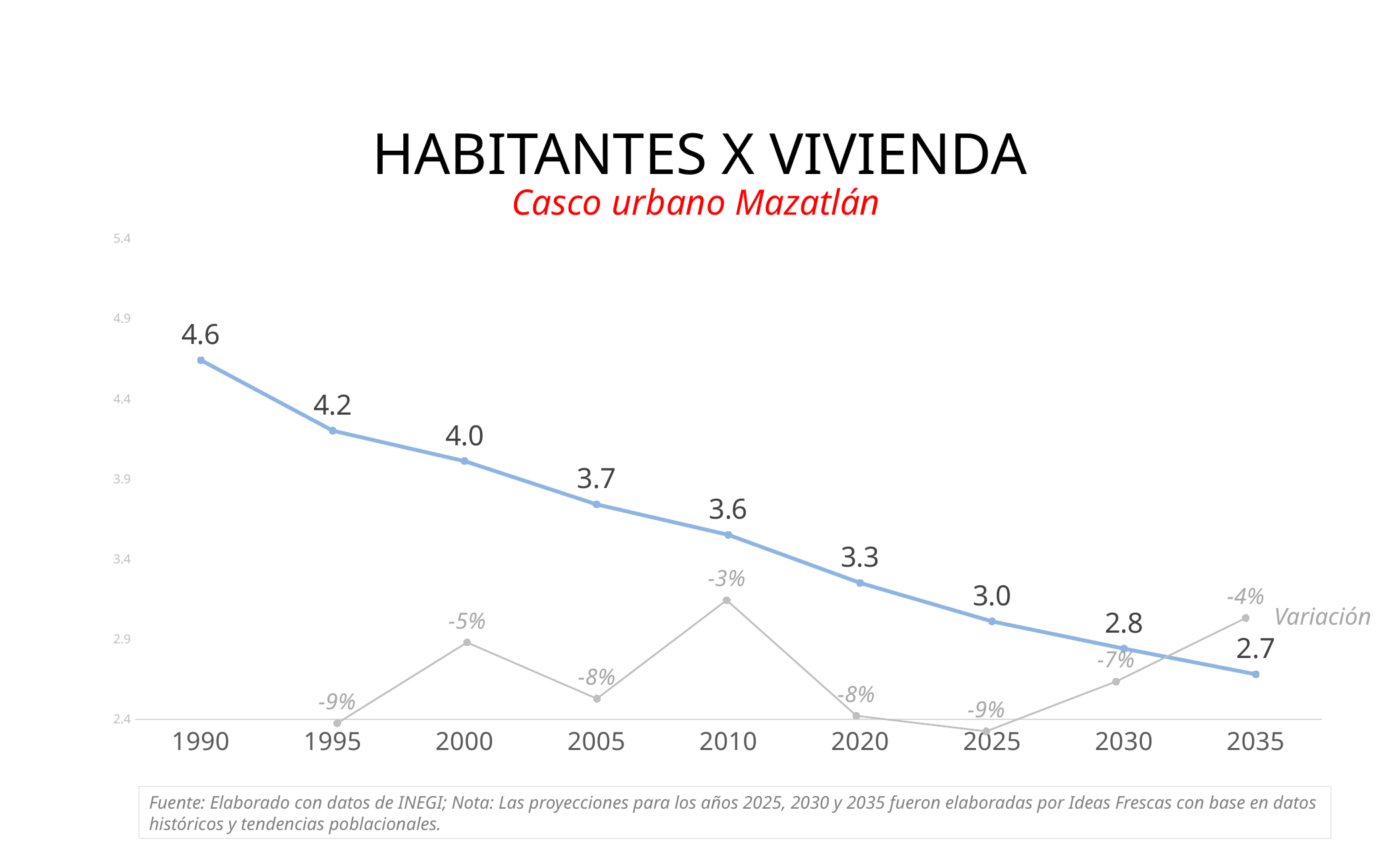
Which is larger, the habitantes por vivienda value for 2005 or for 2020? 2005 What is the value of habitantes por vivienda in 1990? 4.6 What is the value of habitantes por vivienda in 2010? 3.6 Which year has the lowest habitantes por vivienda value? 2035 Do the habitantes por vivienda values rise or fall from 1990 to 2035? Fall Which year has the highest habitantes por vivienda value? 1990 What kind of chart is shown on the slide? Line chart What is the Variación value shown for 2000? -5% What is the difference between the habitantes por vivienda values for 1990 and 2035? 1.9 What is the projected value of habitantes por vivienda in 2035? 2.7 What is the Variación value shown for 2030? -7% How many years are shown on the x axis? 9